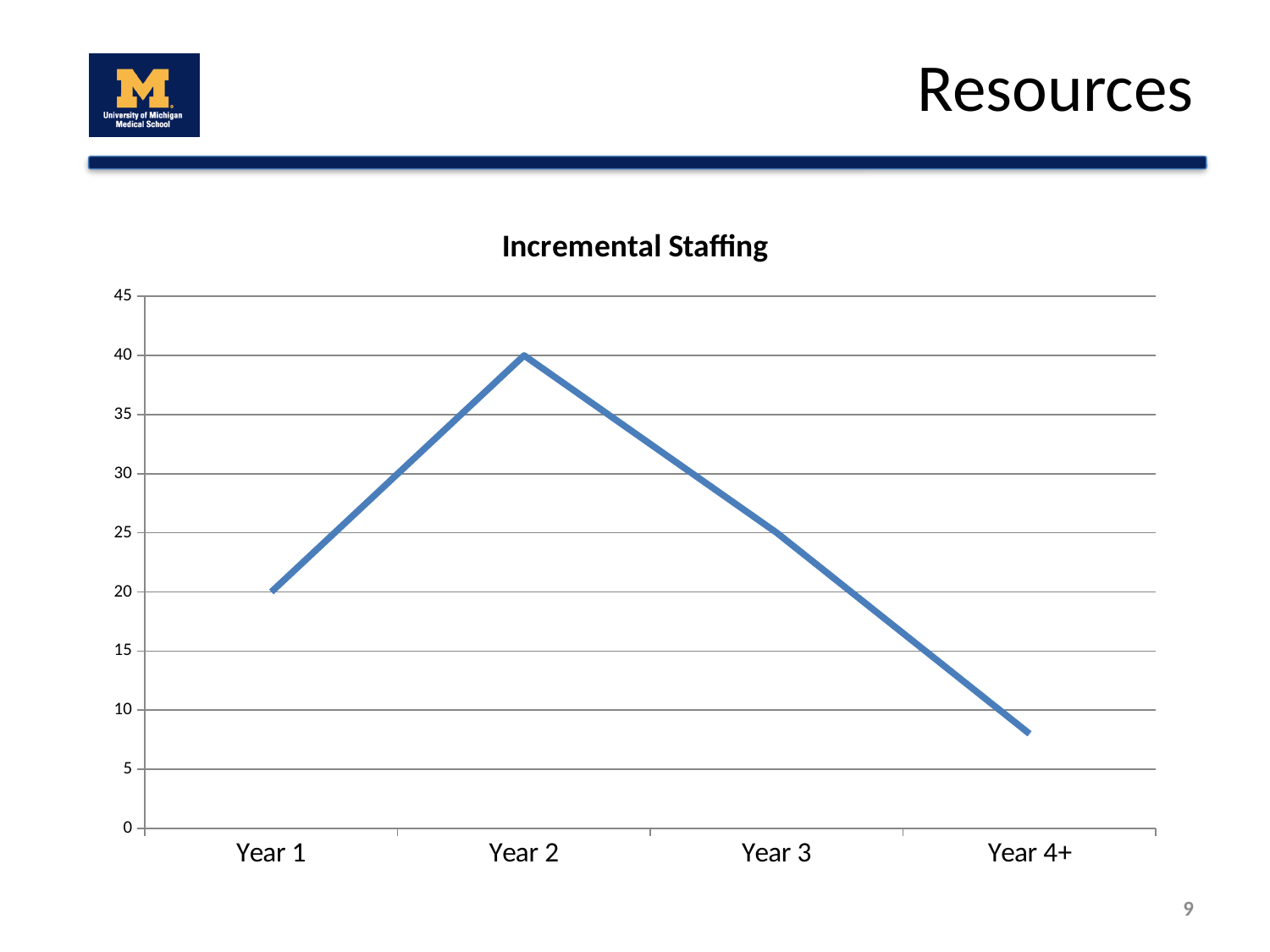
What kind of chart is shown on the slide? line chart What is the incremental staffing value for Year 2? 40 Do the values rise or fall from Year 2 to Year 4+? fall What is the difference between the values for Year 2 and Year 1? 20 What is the incremental staffing value for Year 3? 25 Which year has the highest incremental staffing value? Year 2 Which year has the lowest incremental staffing value? Year 4+ What is the title of the chart? Incremental Staffing Which is larger, the value for Year 1 or the value for Year 3? Year 3 How many points are plotted on the line? 4 Is the value for Year 4+ greater or less than 10? less What is the incremental staffing value for Year 1? 20